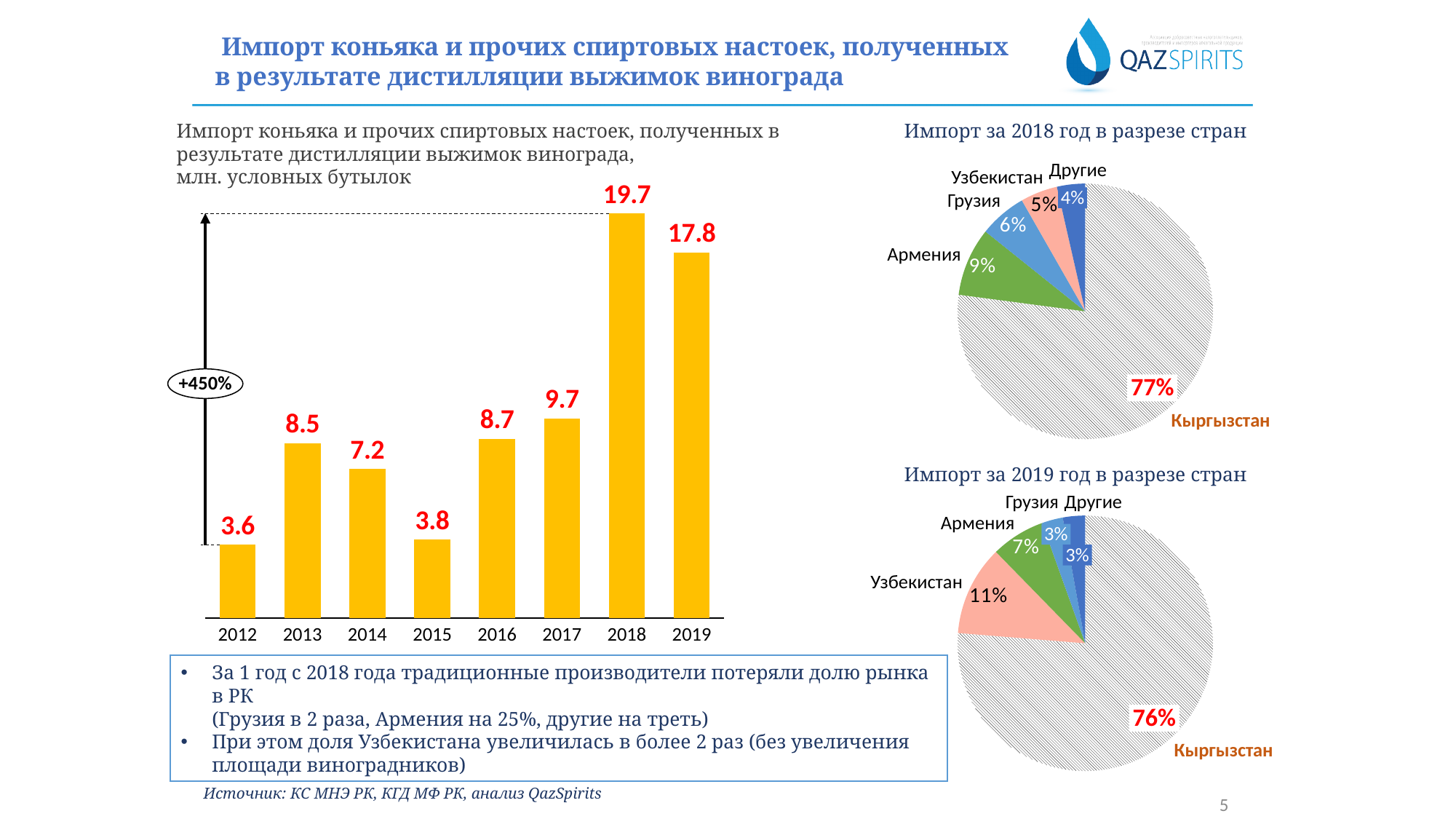
In the bar chart on the left, which year has the lowest value? 2012 In the pie chart 'Импорт за 2018 год в разрезе стран', which country has the smallest share? Другие In the bar chart on the left, what is the value for 2018? 19.7 In the pie chart 'Импорт за 2019 год в разрезе стран', what share does Узбекистан have? 11% In the bar chart on the left, which is larger, the value for 2013 or the value for 2014? 2013 How many years are shown in the bar chart on the left? 8 In the bar chart on the left, which year has the highest value? 2018 In the bar chart on the left, what is the difference between the values for 2018 and 2019? 1.9 In the pie chart 'Импорт за 2018 год в разрезе стран', what share does Кыргызстан have? 77% How many slices does the pie chart 'Импорт за 2019 год в разрезе стран' have? 5 What kind of chart is the chart on the left of the slide? bar chart In the bar chart on the left, what is the value for 2012? 3.6